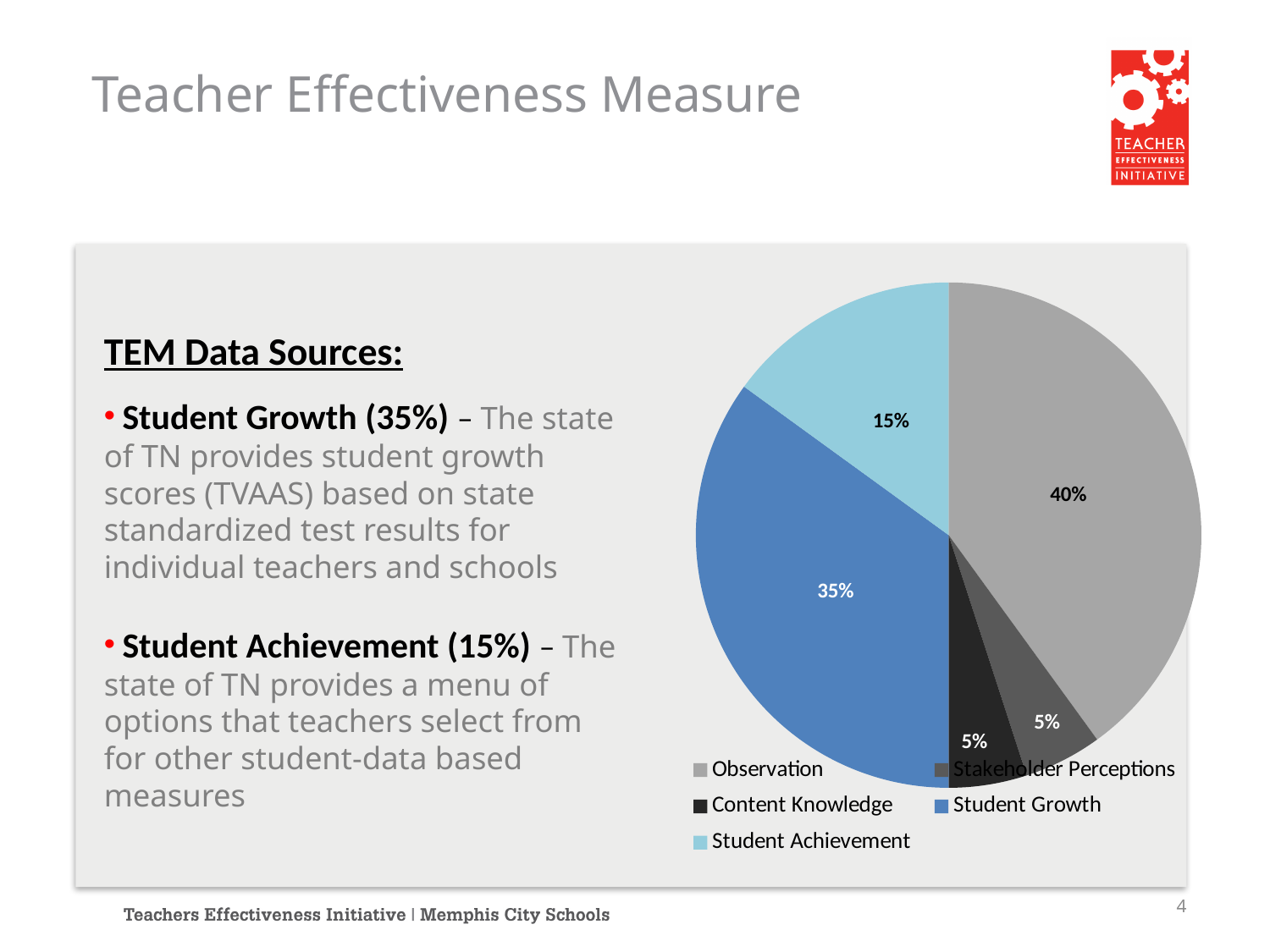
What share of the pie does Content Knowledge represent? 5% What colour is the Student Growth slice? blue What is the difference between the Student Growth share and the Student Achievement share? 20% What share of the pie does Student Growth represent? 35% Which is larger, the Student Achievement slice or the Content Knowledge slice? Student Achievement Which category has the largest slice of the pie? Observation What share of the pie does Observation represent? 40% What kind of chart is shown on the slide? pie chart How many categories does the legend list? 5 What share of the pie does Student Achievement represent? 15% What share of the pie does Stakeholder Perceptions represent? 5% What is the difference between the Observation share and the Student Growth share? 5%